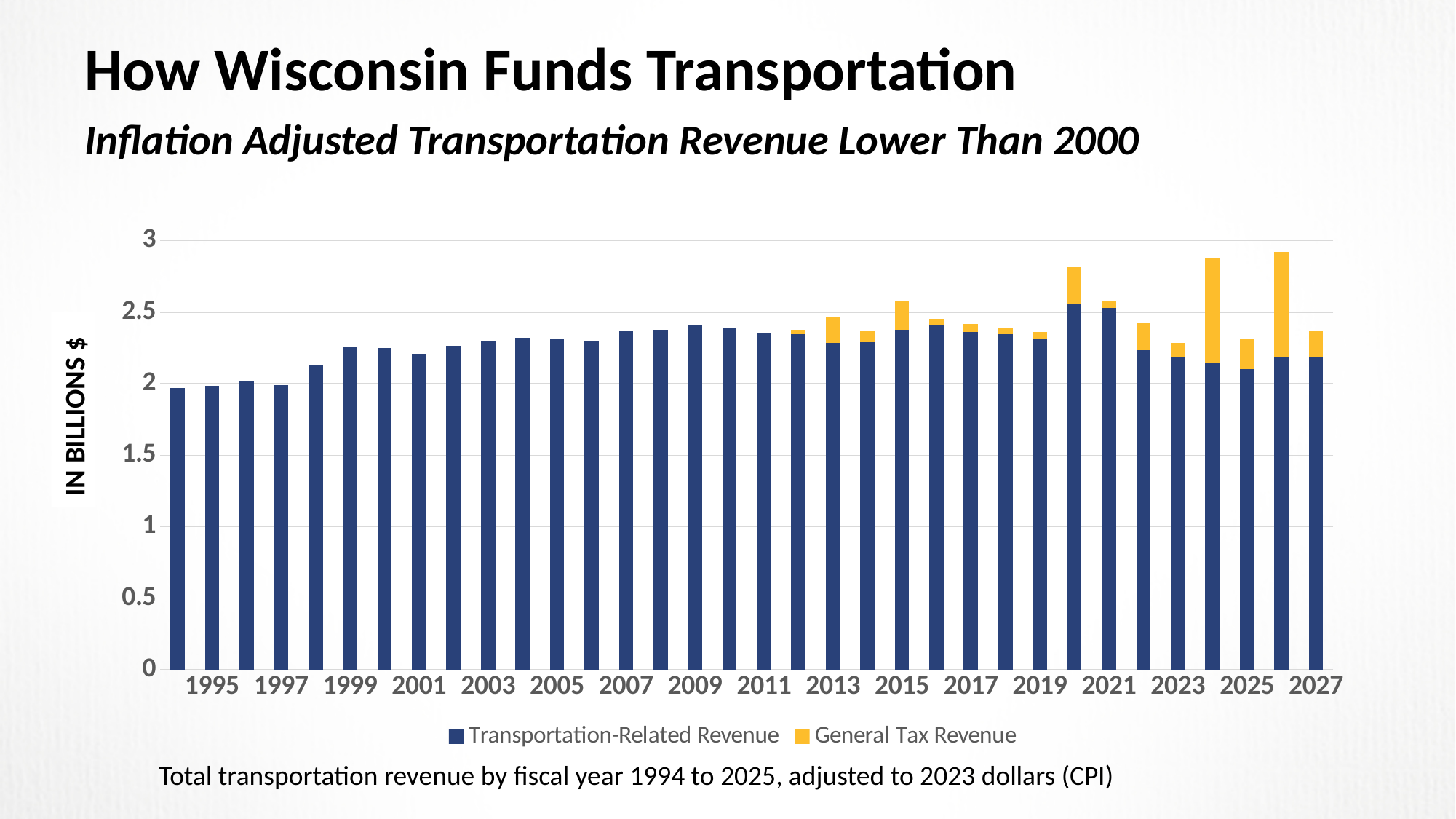
What kind of chart is shown on the slide? Stacked bar chart Is the total stacked bar for 2023 greater or less than 2.5? less What are the two series named in the legend? Transportation-Related Revenue and General Tax Revenue What is the label on the vertical axis? IN BILLIONS $ Is the Transportation-Related Revenue value for 1999 greater or less than 2? greater How many series does the legend list? 2 Is the Transportation-Related Revenue value for 2025 greater or less than 2.5? less Which year has the larger General Tax Revenue segment, 2024 or 2025? 2024 Which year has the larger total stacked bar, 2020 or 2021? 2020 Does Transportation-Related Revenue generally rise or fall from 1994 to 2009? rise